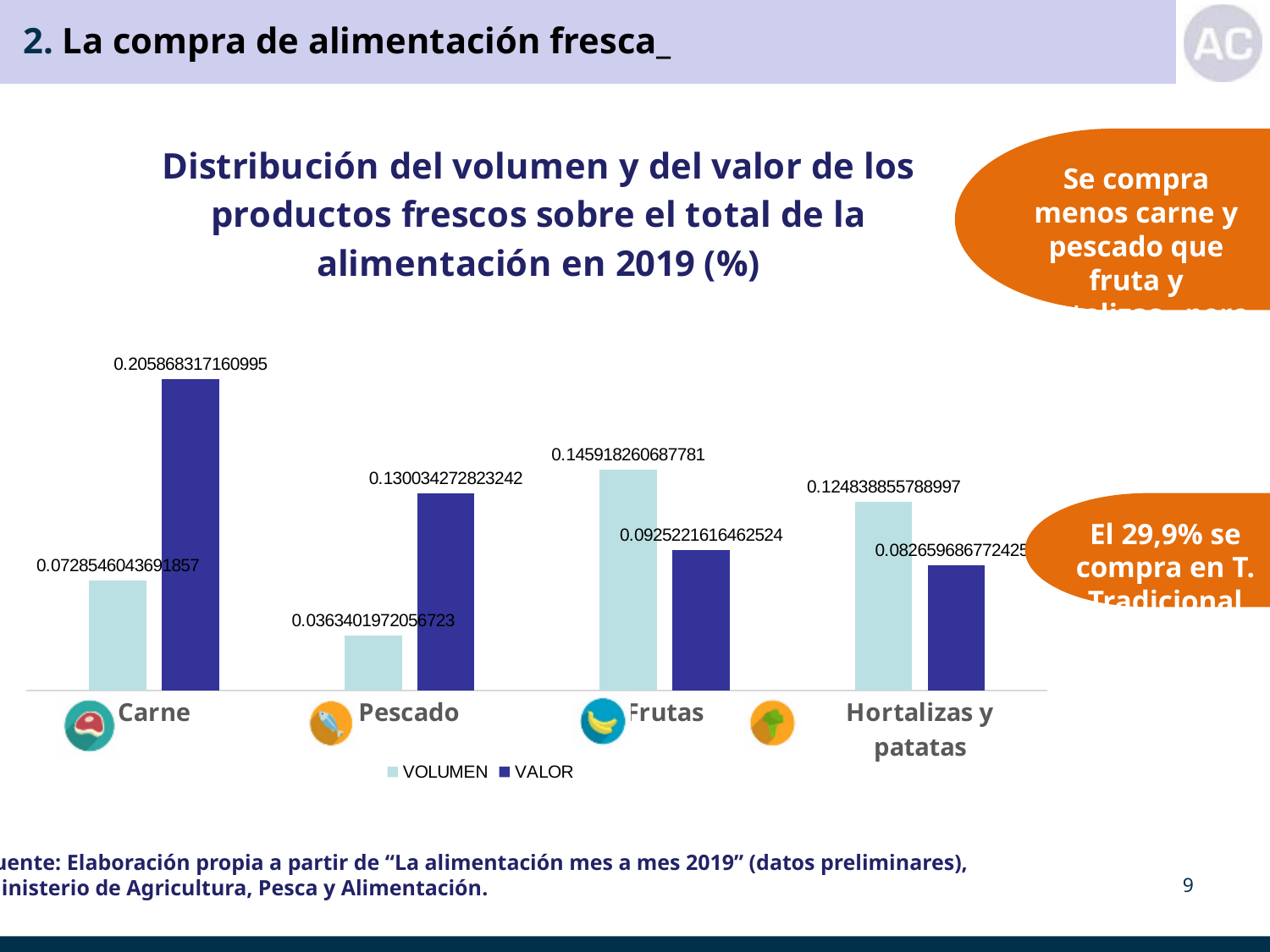
How many categories are shown on the x axis? 4 What is the VOLUMEN value for Carne? 0.0728546043691857 What is the VALOR value for Frutas? 0.0925221616462524 How many series does the legend list? 2 What is the VOLUMEN value for Hortalizas y patatas? 0.124838855788997 Which category has the highest VALOR value? Carne What is the VALOR value for Pescado? 0.130034272823242 What is the VALOR value for Carne? 0.205868317160995 Which category has the lowest VOLUMEN value? Pescado What is the VOLUMEN value for Pescado? 0.0363401972056723 What is the VOLUMEN value for Frutas? 0.145918260687781 For Frutas, which is larger, VOLUMEN or VALOR? VOLUMEN